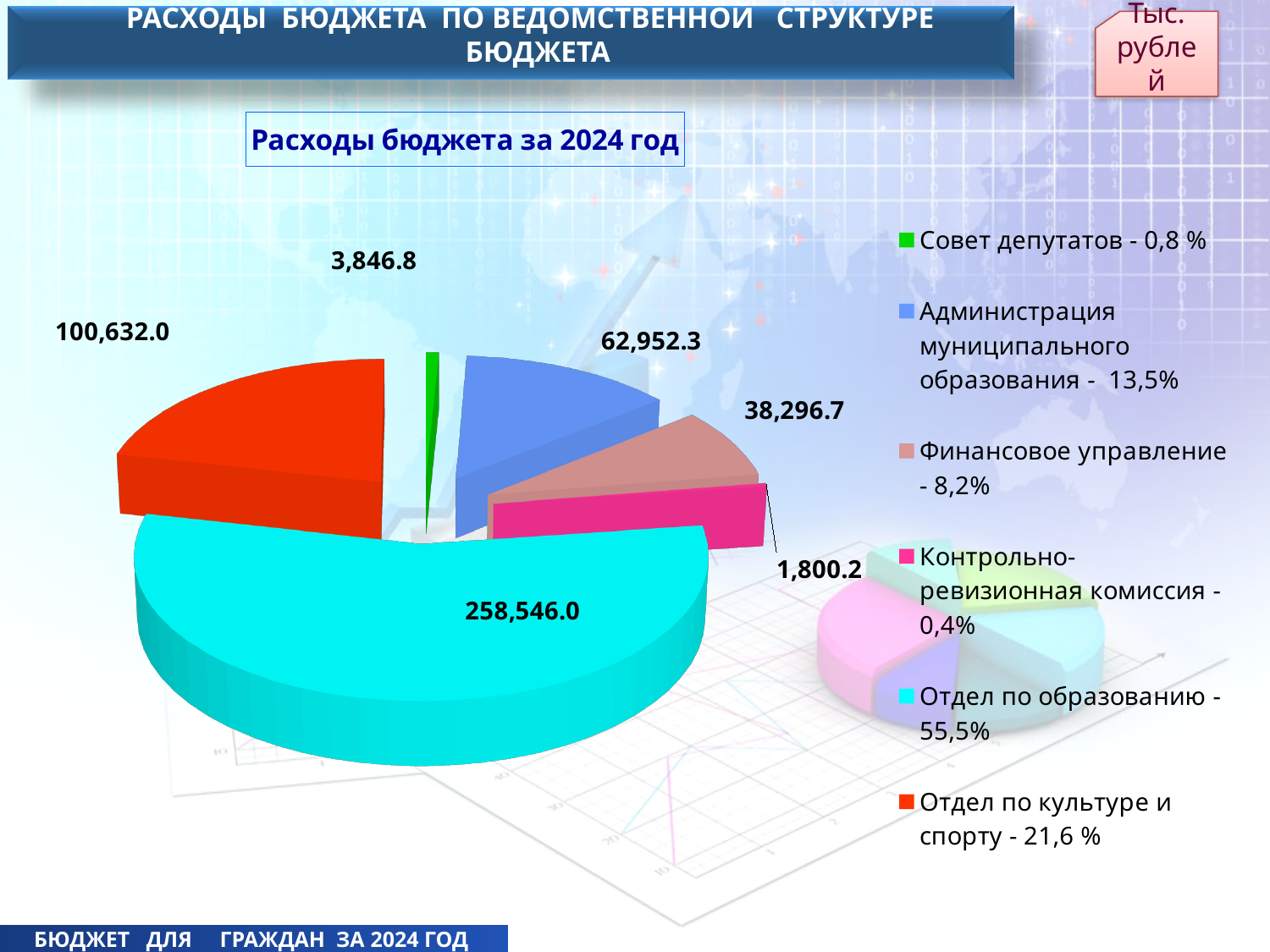
How many categories does the pie chart have? 6 What is the difference between the values for Отдел по культуре и спорту and Администрация муниципального образования? 37,679.7 What is the value for Контрольно-ревизионная комиссия? 1,800.2 What is the value for Отдел по культуре и спорту? 100,632.0 What kind of chart is shown on the slide? Pie chart What is the value for Финансовое управление? 38,296.7 Which category has the smallest slice of the pie? Контрольно-ревизионная комиссия Which is larger, the value for Совет депутатов or the value for Контрольно-ревизионная комиссия? Совет депутатов What share of the pie does Отдел по образованию represent, according to the legend? 55,5% What is the value for Отдел по образованию? 258,546.0 Which category has the largest slice of the pie? Отдел по образованию What is the value for Администрация муниципального образования? 62,952.3